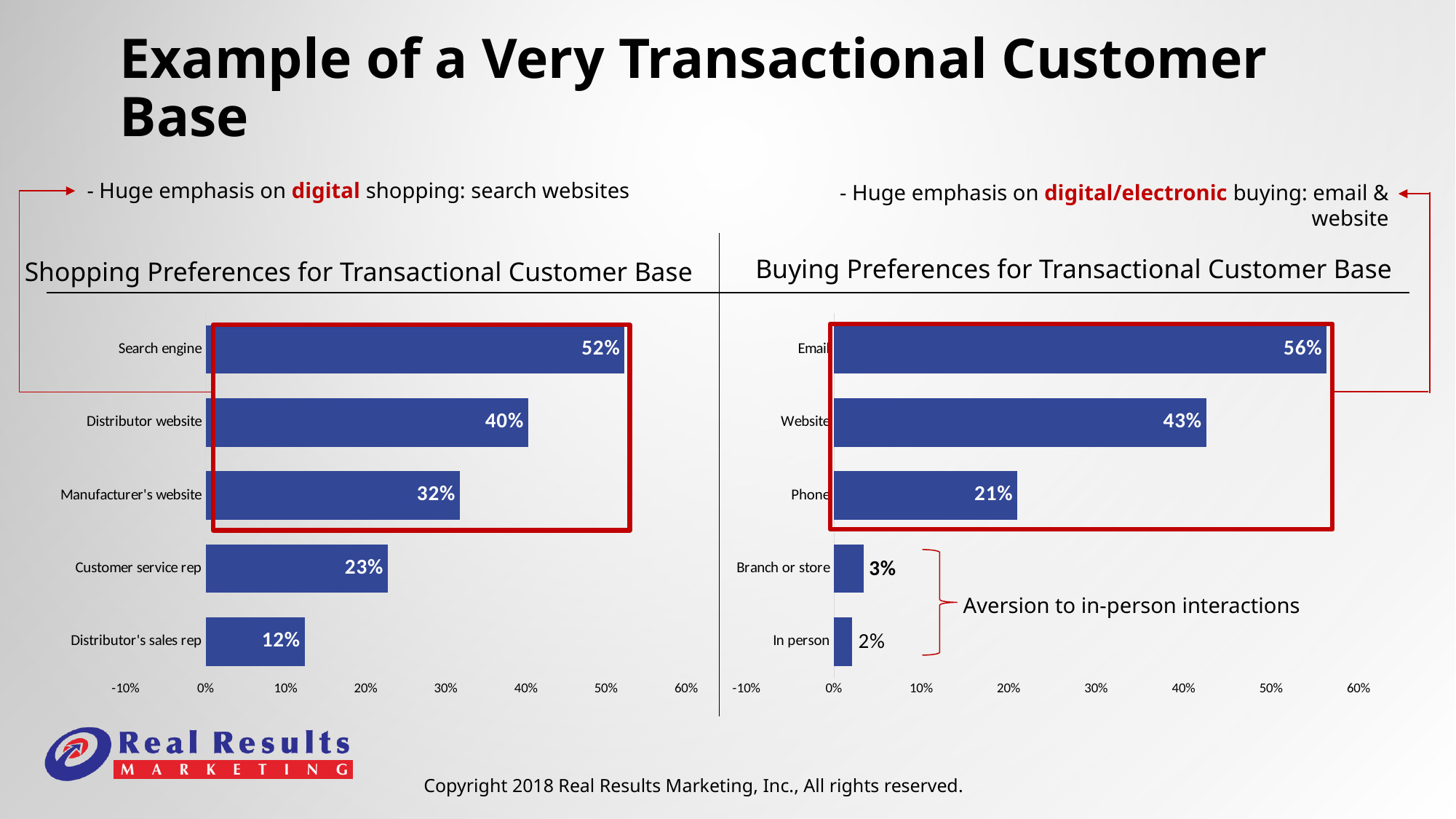
In the 'Shopping Preferences for Transactional Customer Base' chart, what is the value for Customer service rep? 23% In the 'Buying Preferences for Transactional Customer Base' chart, what is the value for Website? 43% What kind of chart is the 'Buying Preferences for Transactional Customer Base' chart? Bar chart In the 'Buying Preferences for Transactional Customer Base' chart, what is the difference between Email and Phone? 35% In the 'Buying Preferences for Transactional Customer Base' chart, is the value for Phone greater or less than 30%? less In the 'Shopping Preferences for Transactional Customer Base' chart, which category has the lowest value? Distributor's sales rep How many categories are shown in the 'Shopping Preferences for Transactional Customer Base' chart? 5 In the 'Buying Preferences for Transactional Customer Base' chart, what is the value for In person? 2% In the 'Shopping Preferences for Transactional Customer Base' chart, what is the difference between Distributor website and Manufacturer's website? 8% In the 'Shopping Preferences for Transactional Customer Base' chart, what is the value for Search engine? 52% In the 'Buying Preferences for Transactional Customer Base' chart, which category has the highest value? Email In the 'Shopping Preferences for Transactional Customer Base' chart, which is larger: Customer service rep or Distributor's sales rep? Customer service rep